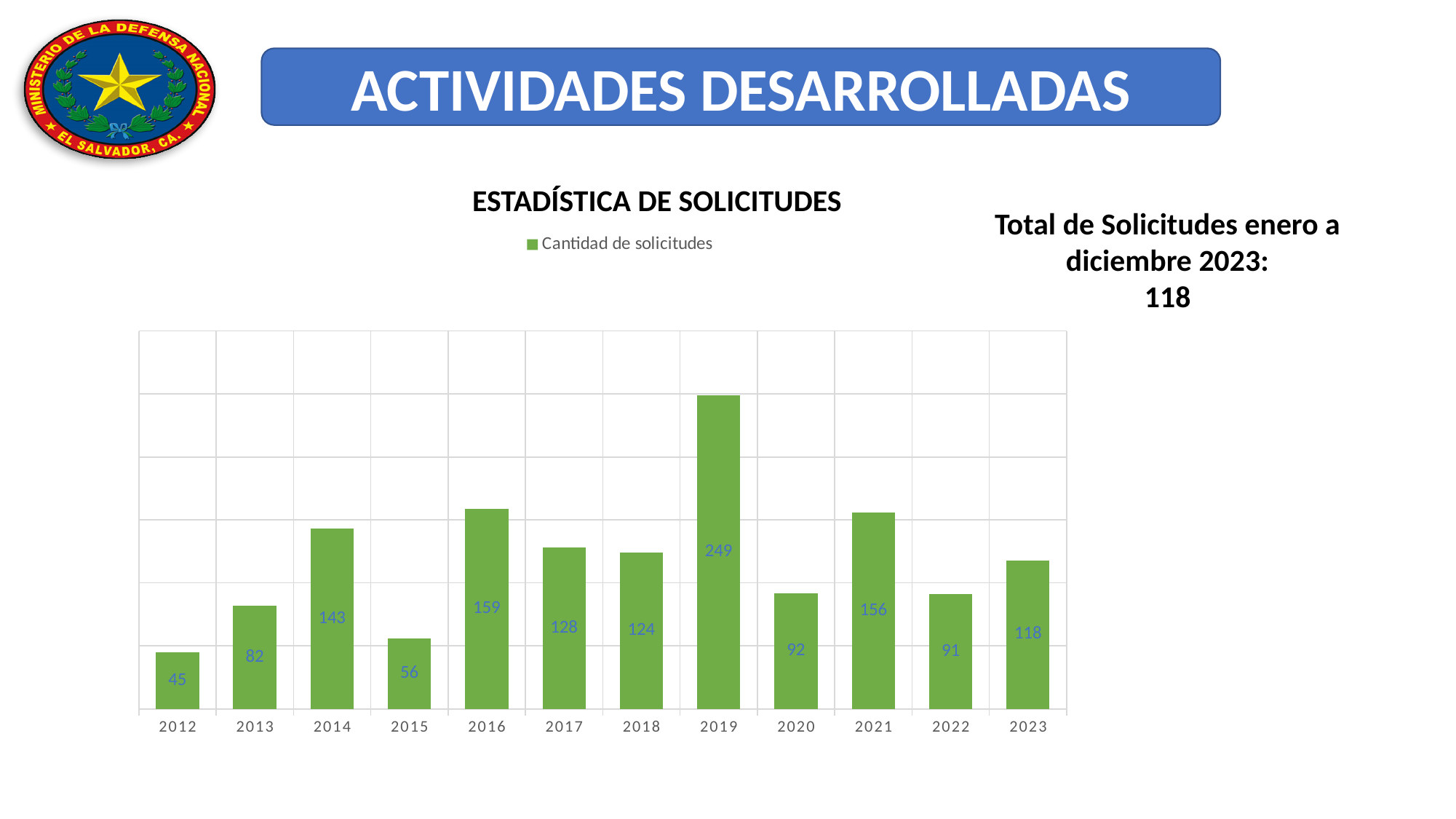
What type of chart is shown on the slide? bar chart Which is larger, the value for 2017 or the value for 2020? 2017 How many years are shown on the x axis of the chart? 12 What is the value for 2023 in the chart? 118 What is the difference between the values for 2014 and 2015? 87 What is the value for 2016 in the chart? 159 What is the value for 2012 in the chart? 45 What is the title of the chart? ESTADÍSTICA DE SOLICITUDES What is the value for 2019 in the chart? 249 What is the difference between the values for 2019 and 2021? 93 Which year has the lowest number of solicitudes? 2012 Which year has the highest number of solicitudes? 2019